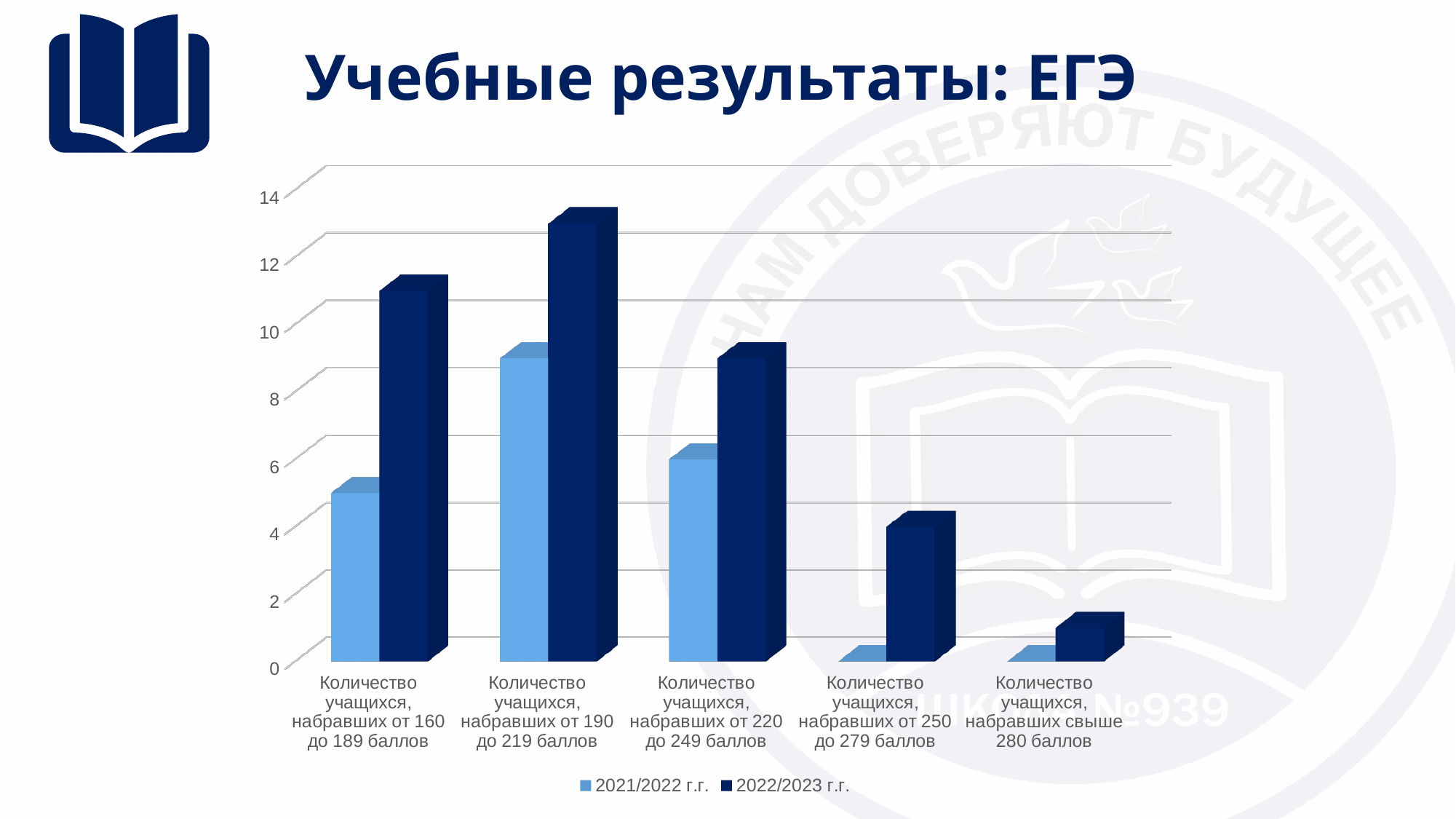
Is the 2022/2023 г.г. value for students scoring 160 to 189 points greater or less than 10? greater How many categories are shown on the x axis? 5 What is the title of the slide? Учебные результаты: ЕГЭ Is the 2022/2023 г.г. value for students scoring 190 to 219 points greater or less than 12? greater What kind of chart is shown on the slide? Bar chart How many series does the legend list? 2 Is the 2021/2022 г.г. value for students scoring 160 to 189 points greater or less than 6? less Which category has the highest value for the 2021/2022 г.г. series? Количество учащихся, набравших от 190 до 219 баллов Which category has the lowest value for the 2022/2023 г.г. series? Количество учащихся, набравших свыше 280 баллов For students scoring 160 to 189 points, which series has the larger value: 2021/2022 г.г. or 2022/2023 г.г.? 2022/2023 г.г. Which category has the highest value for the 2022/2023 г.г. series? Количество учащихся, набравших от 190 до 219 баллов